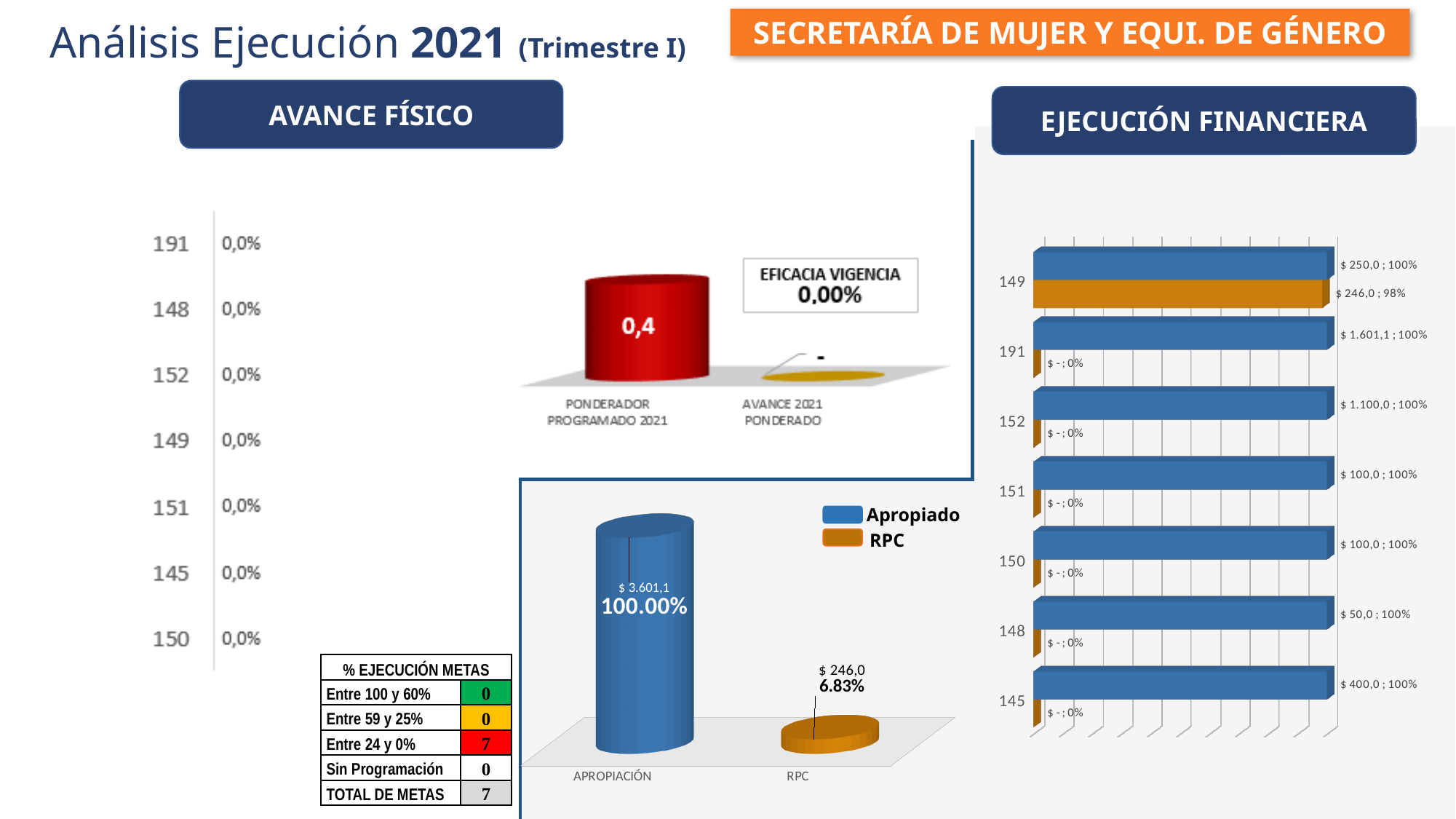
In the Ejecución Financiera bar chart on the right, what colour represents the RPC series? Orange In the bottom-middle chart with APROPIACIÓN and RPC, what value is labelled on the APROPIACIÓN cylinder? $ 3.601,1 In the top-middle chart, what is the EFICACIA VIGENCIA value shown? 0.00% In the Ejecución Financiera bar chart on the right, what is the Apropiado value for category 191? $ 1.601,1 ; 100% In the Ejecución Financiera bar chart on the right, how many categories are shown on the vertical axis? 7 In the top-middle chart, what value is shown for PONDERADOR PROGRAMADO 2021? 0,4 In the Ejecución Financiera bar chart on the right, how many series does the legend list? 2 In the Ejecución Financiera bar chart on the right, what is the RPC value for category 149? $ 246,0 ; 98% In the bottom-middle chart with APROPIACIÓN and RPC, what percentage is shown for RPC? 6.83%